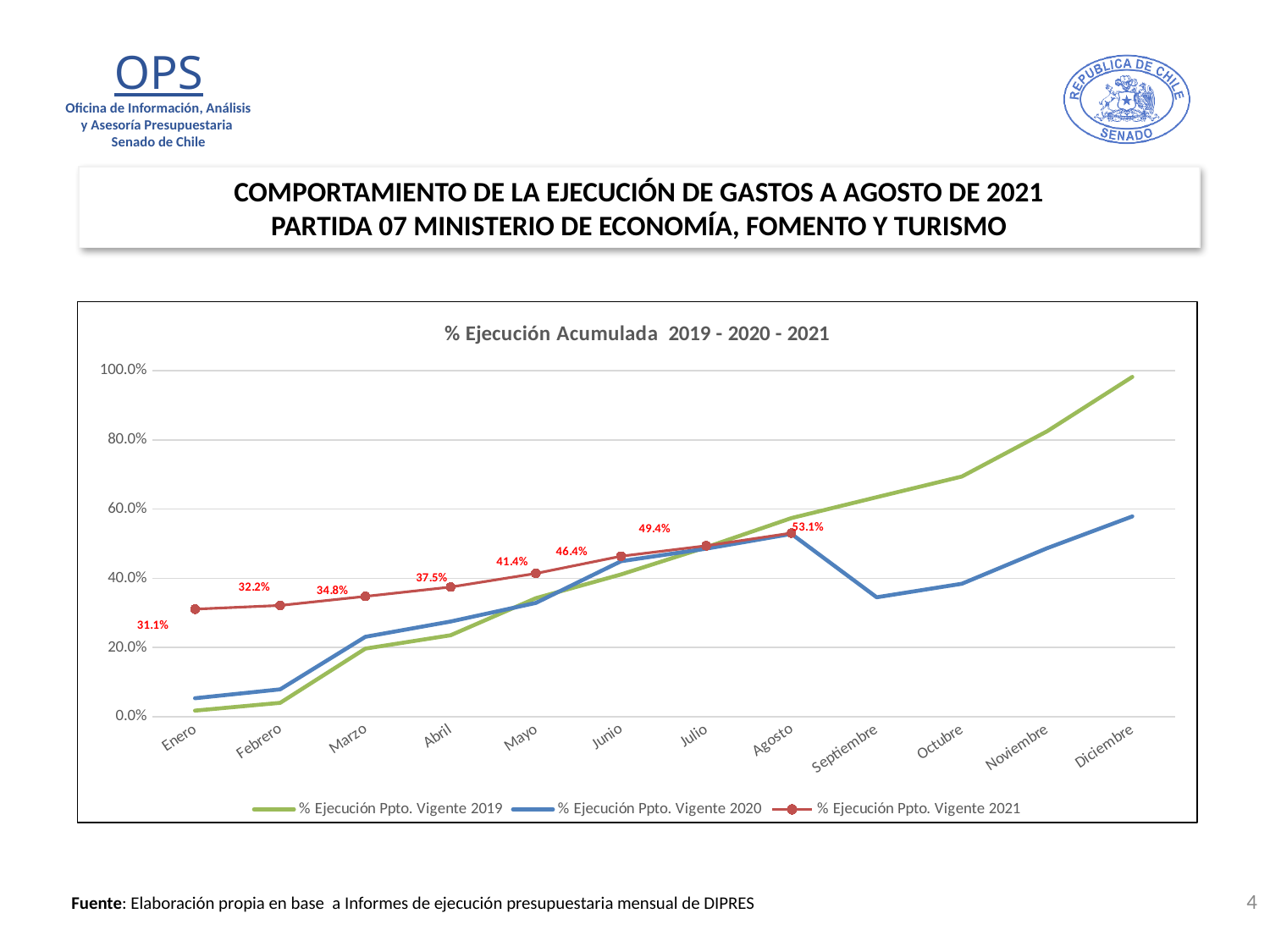
How many series does the legend list? 3 What kind of chart is shown on the slide? Line chart What is the difference between the 2021 values for Agosto and Enero? 22.0% Which month has the lowest value for % Ejecución Ppto. Vigente 2021? Enero Is the value of % Ejecución Ppto. Vigente 2019 for Diciembre greater or less than 80.0%? greater What is the value of % Ejecución Ppto. Vigente 2021 for Enero? 31.1% What is the value of % Ejecución Ppto. Vigente 2021 for Mayo? 41.4% Which month has the highest value for % Ejecución Ppto. Vigente 2021? Agosto Which is larger in Febrero: the 2021 value or the 2020 value? 2021 Is the value of % Ejecución Ppto. Vigente 2020 for Enero greater or less than 20.0%? less What is the value of % Ejecución Ppto. Vigente 2021 for Agosto? 53.1% What is the difference between the 2021 values for Junio and Mayo? 5.0%